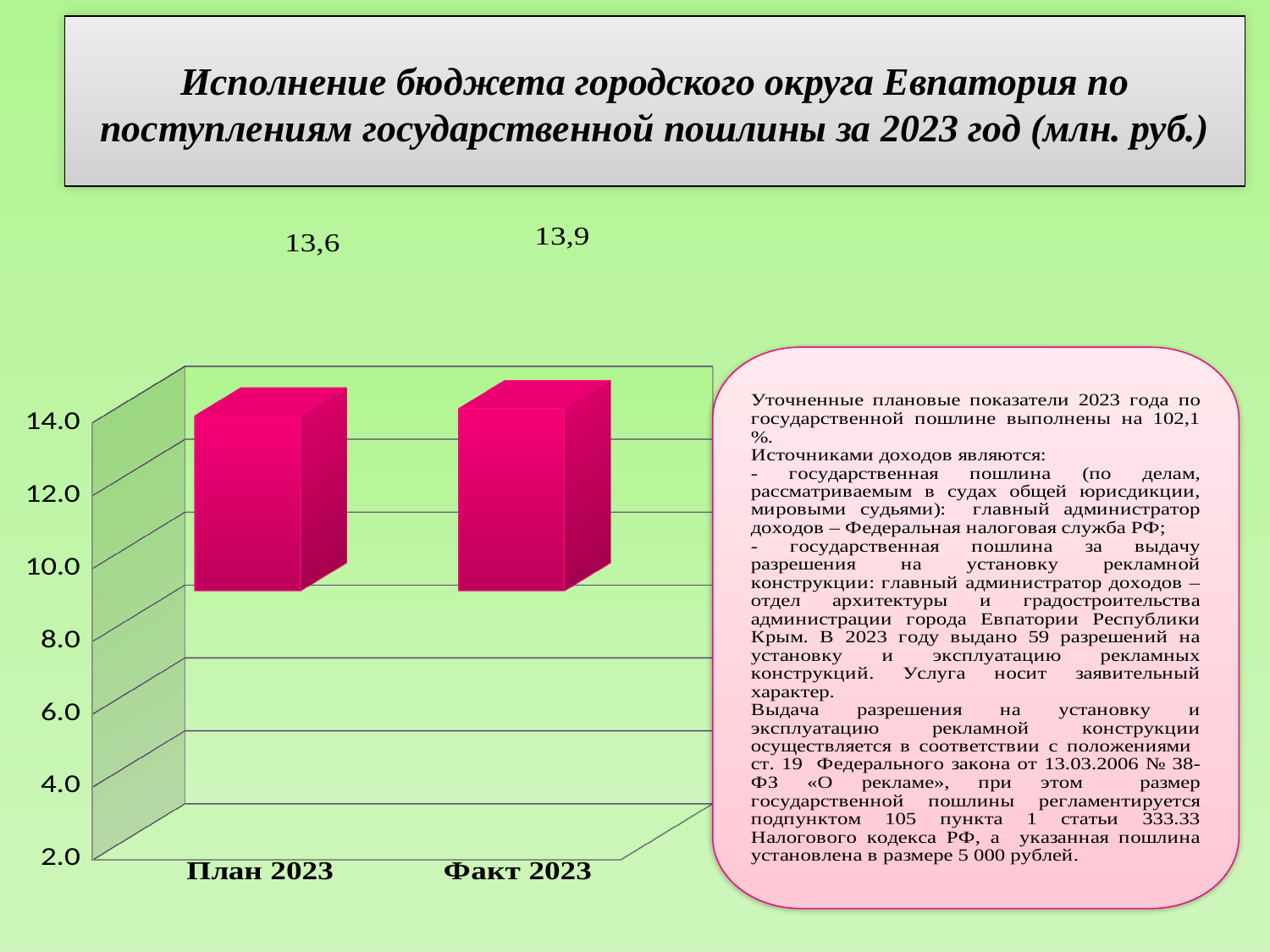
Which category has the highest value? Факт 2023 Which category has the lowest value? План 2023 Which category has the higher value, План 2023 or Факт 2023? Факт 2023 What kind of chart is shown on the slide? bar chart Is the value for План 2023 greater or less than 12.0? greater Do the values rise or fall from План 2023 to Факт 2023? rise How many categories are shown on the chart? 2 What is the value for План 2023? 13,6 What unit of measurement is given in the slide title? млн. руб. What is the difference between the values for Факт 2023 and План 2023? 0,3 What is the value for Факт 2023? 13,9